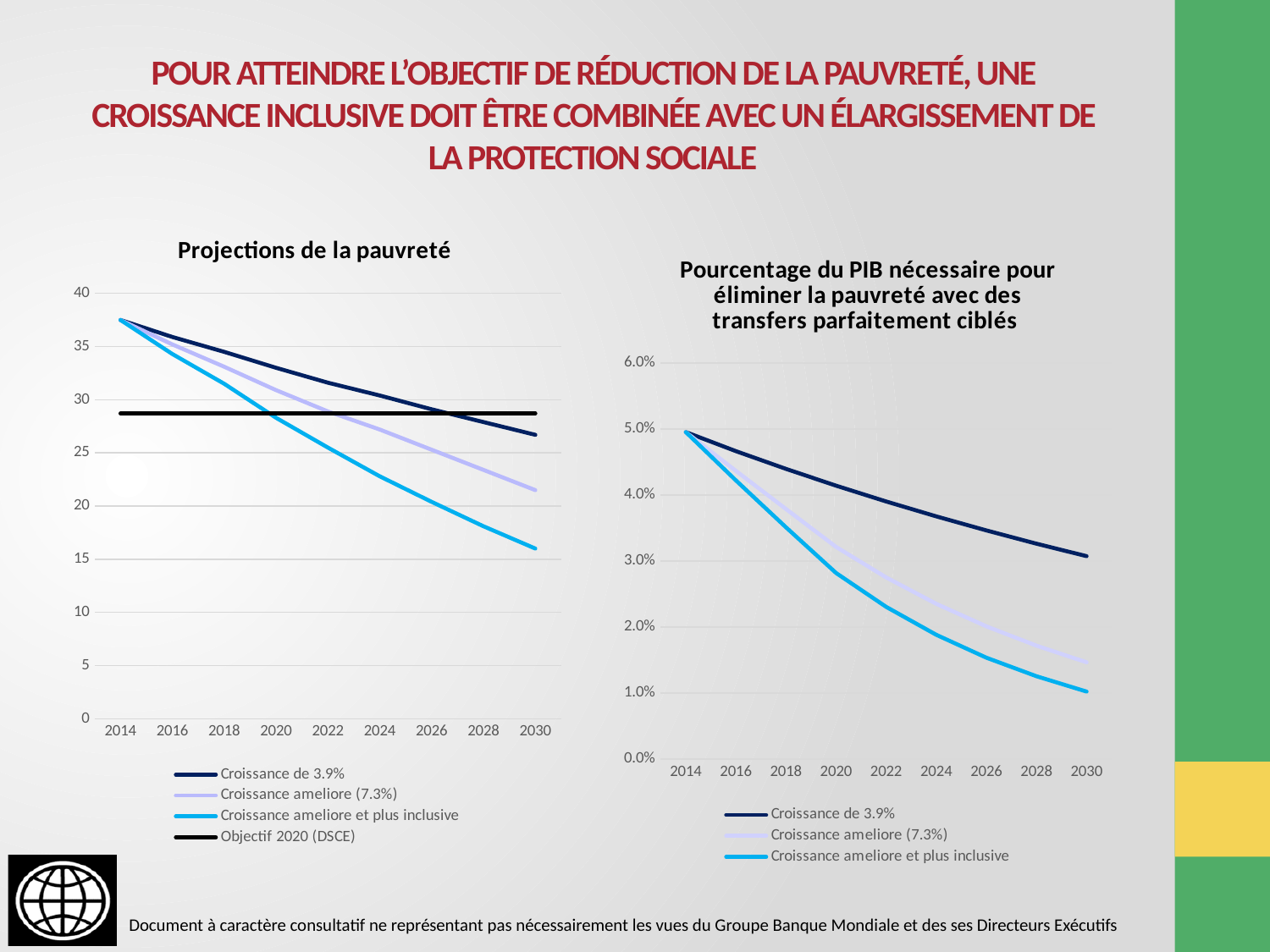
In the 'Projections de la pauvreté' chart, does the 'Croissance ameliore et plus inclusive' series rise or fall from 2014 to 2030? fall In the 'Pourcentage du PIB nécessaire' chart, which is larger in 2030: 'Croissance de 3.9%' or 'Croissance ameliore (7.3%)'? Croissance de 3.9% In the 'Projections de la pauvreté' chart, which series has the lowest value in 2030? Croissance ameliore et plus inclusive How many series does the legend of the 'Projections de la pauvreté' chart list? 4 In the 'Projections de la pauvreté' chart, is the value for 'Croissance ameliore et plus inclusive' in 2030 greater or less than 20? less How many series does the legend of the 'Pourcentage du PIB nécessaire pour éliminer la pauvreté avec des transfers parfaitement ciblés' chart list? 3 In the 'Projections de la pauvreté' chart, is the 'Objectif 2020 (DSCE)' line greater or less than 30? less In the 'Projections de la pauvreté' chart, is the value for 'Croissance de 3.9%' in 2030 greater or less than 25? greater In the 'Pourcentage du PIB nécessaire' chart, which series has the highest value in 2030? Croissance de 3.9% What kind of chart is the 'Projections de la pauvreté' chart? line chart How many years are labelled on the x axis of the 'Projections de la pauvreté' chart? 9